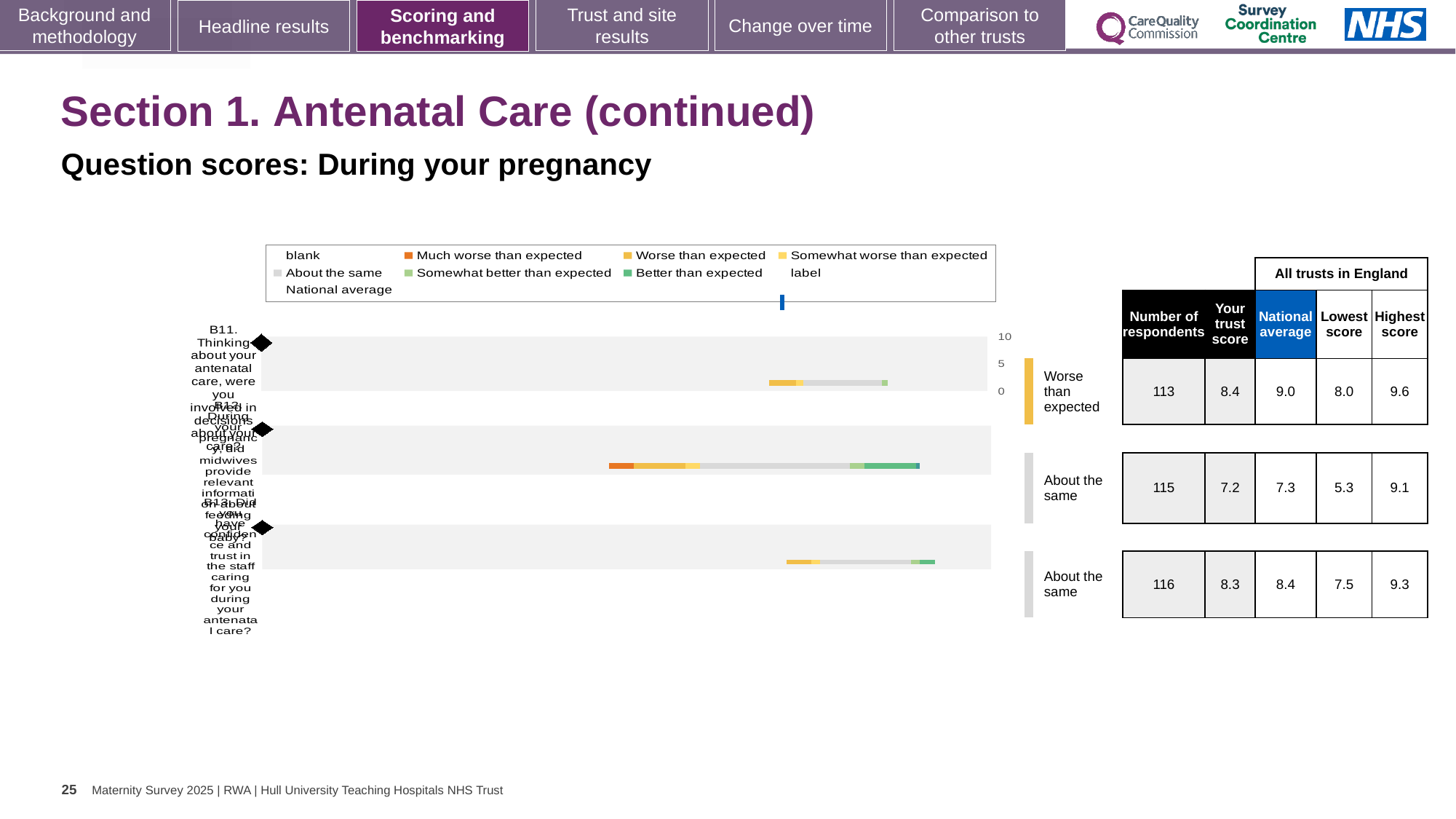
Which row of the table has the highest 'Your trust score'? the first row (B11), 8.4 What kind of chart is shown on the slide? bar chart In the table, what is the 'Number of respondents' for the second row (B12)? 115 Which has more respondents in the table: the second row (B12) or the third row (B13)? the third row (B13), 116 What is the highest tick value shown on the chart's axis? 10 In the table, what is the 'Your trust score' for the first row (B11)? 8.4 In the table, what is the 'Highest score' for the third row (B13)? 9.3 What benchmark category is shown next to the first bar (B11)? Worse than expected Which row of the table has the lowest 'Lowest score'? the second row (B12), 5.3 In the first row of the table, what is the difference between the National average and Your trust score? 0.6 How many questions (bars) are plotted in the chart? 3 What colour does the legend use for 'Much worse than expected'? orange